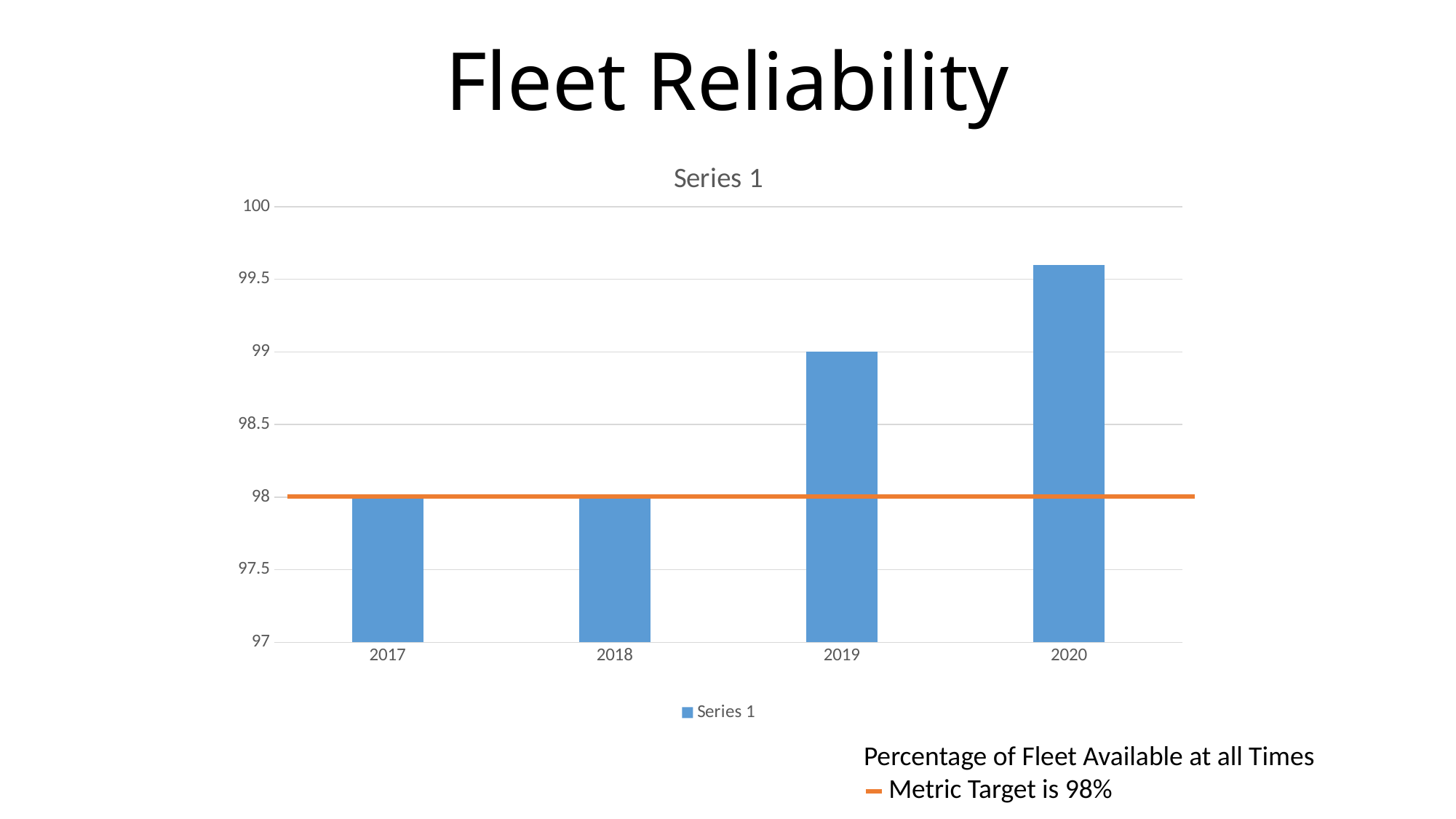
Which is larger, the value for 2019 or the value for 2020? 2020 Which year has the highest value? 2020 Is the value for 2019 greater or less than 98.5? greater What is the value for 2019? 99 What is the title shown above the chart? Series 1 How many years are shown on the x axis of the chart? 4 What kind of chart is shown on the slide? bar chart What is the value for 2017? 98 Is the value for 2020 greater or less than 99.5? greater Do the values rise or fall from 2017 to 2020? rise How many series does the chart legend list? 1 What value does the orange metric target line represent? 98%